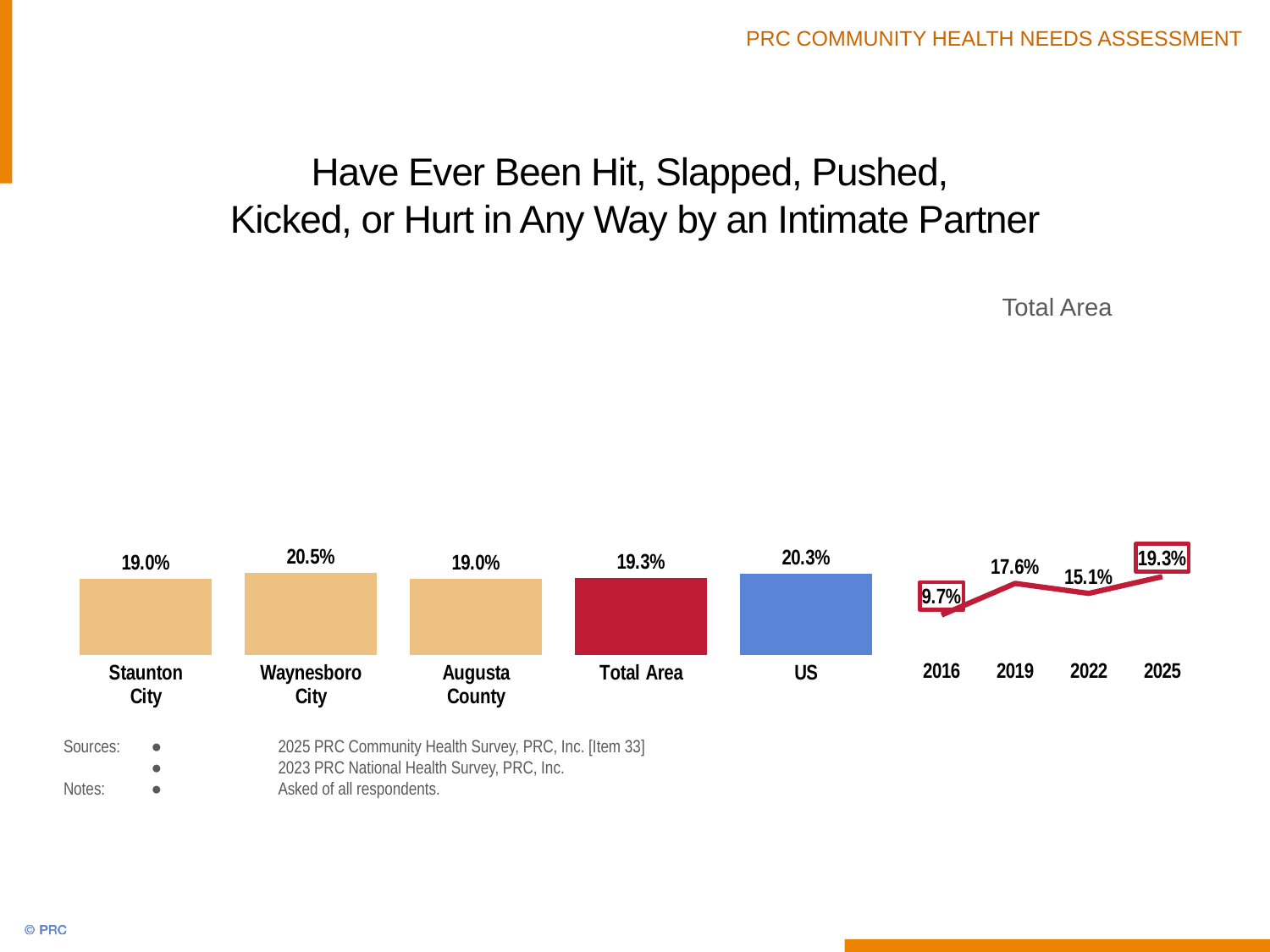
What kind of chart is on the left side of the slide? Bar chart In the Total Area trend chart, what is the difference between the 2025 value and the 2016 value? 9.6% In the Total Area trend chart, which year has the lowest value? 2016 In the bar chart, what is the value for Waynesboro City? 20.5% How many categories are shown in the bar chart? 5 In the Total Area trend chart, what is the value for 2022? 15.1% In the Total Area trend chart, what is the value for 2016? 9.7% In the bar chart, which is larger: the value for Total Area or the value for the US? US In the bar chart, which category has the highest value? Waynesboro City In the bar chart, what is the value for the US? 20.3% In the bar chart, what is the difference between the Waynesboro City value and the Total Area value? 1.2% What kind of chart is the Total Area chart on the right side of the slide? Line chart